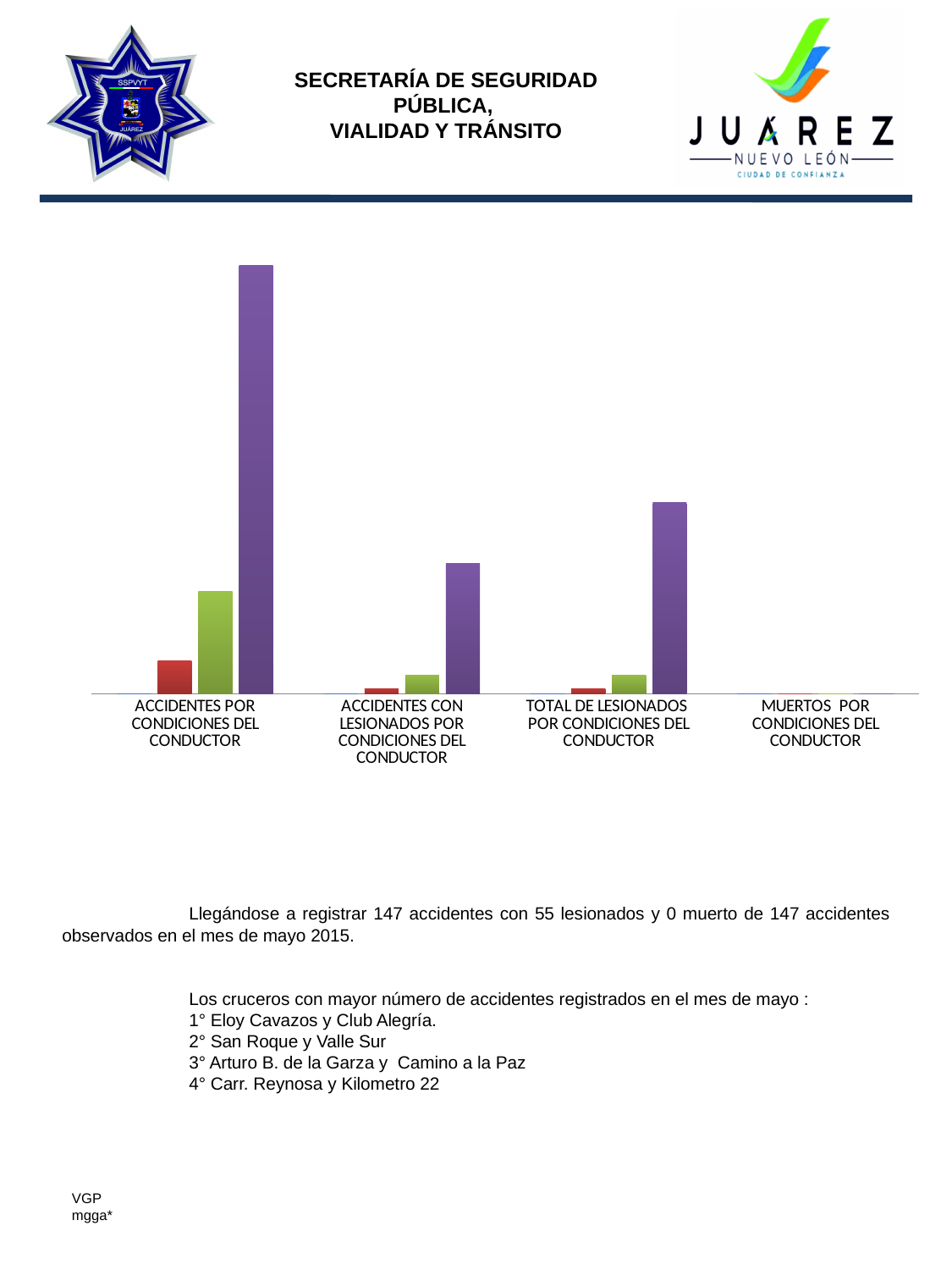
In the category ACCIDENTES POR CONDICIONES DEL CONDUCTOR, is the red bar or the green bar taller? green Which category shows no visible bars in the chart? MUERTOS POR CONDICIONES DEL CONDUCTOR Which category has the tallest bar in the chart? ACCIDENTES POR CONDICIONES DEL CONDUCTOR Is the purple bar taller for ACCIDENTES CON LESIONADOS POR CONDICIONES DEL CONDUCTOR or for TOTAL DE LESIONADOS POR CONDICIONES DEL CONDUCTOR? TOTAL DE LESIONADOS POR CONDICIONES DEL CONDUCTOR Is the green bar taller for ACCIDENTES POR CONDICIONES DEL CONDUCTOR or for TOTAL DE LESIONADOS POR CONDICIONES DEL CONDUCTOR? ACCIDENTES POR CONDICIONES DEL CONDUCTOR Does the chart display a legend? No What kind of chart is shown on the slide? bar chart Which colour of bar is the tallest within each category that has bars? purple How many categories are shown along the x axis of the chart? 4 How many bars are plotted for the category ACCIDENTES POR CONDICIONES DEL CONDUCTOR? 3